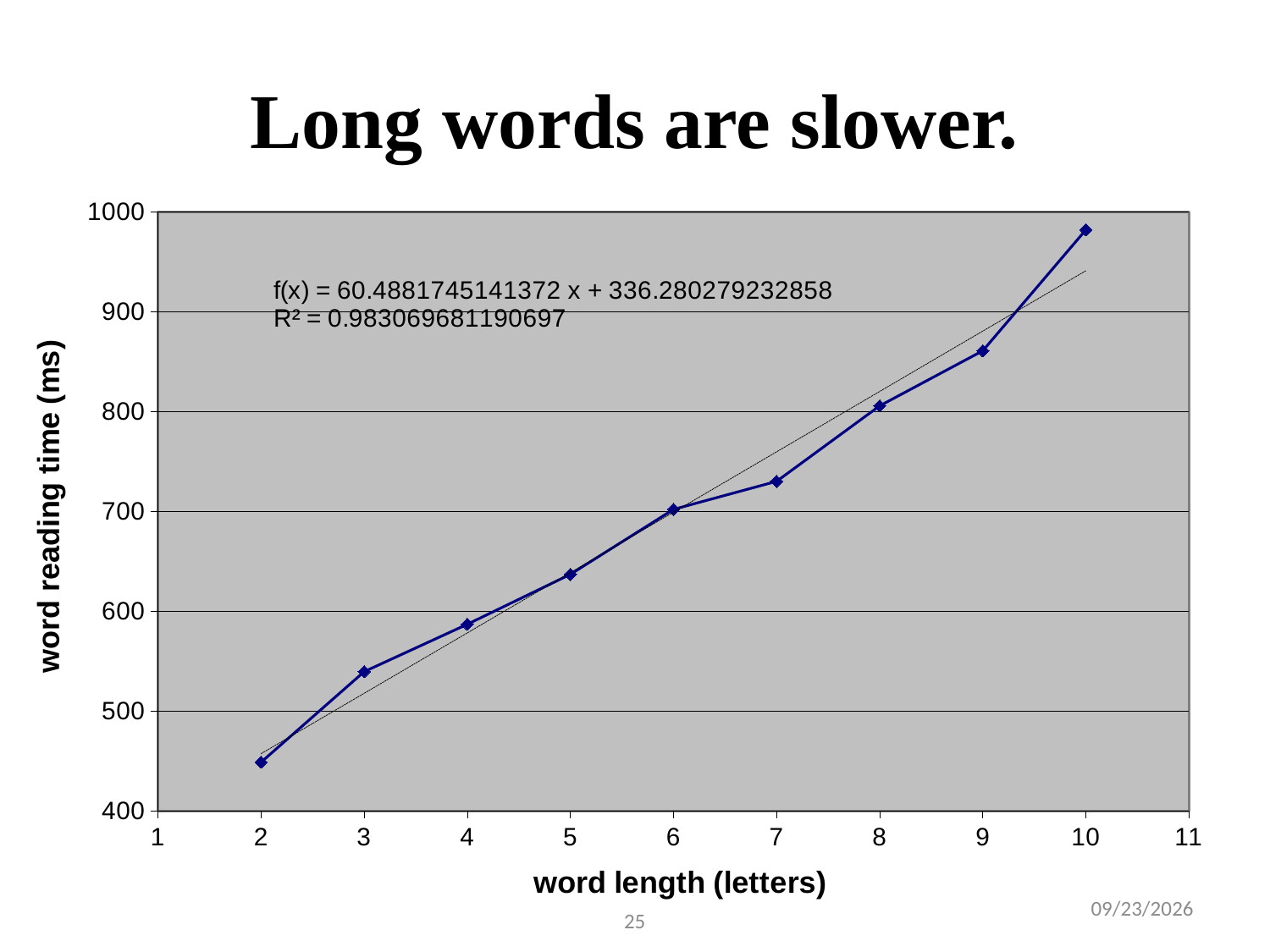
Which has a larger word reading time, a word length of 3 letters or 7 letters? 7 letters Is the word reading time for a word length of 4 letters greater or less than 600? less Does word reading time rise or fall as word length increases? rise Which word length has the highest word reading time? 10 Which word length has the lowest word reading time? 2 Is the word reading time for a word length of 2 letters greater or less than 500? less What R² value is printed on the chart? 0.983069681190697 Is the word reading time for a word length of 10 letters greater or less than 900? greater What kind of chart is shown on the slide? line chart How many data points are plotted on the chart? 9 What is the title of the y axis? word reading time (ms)